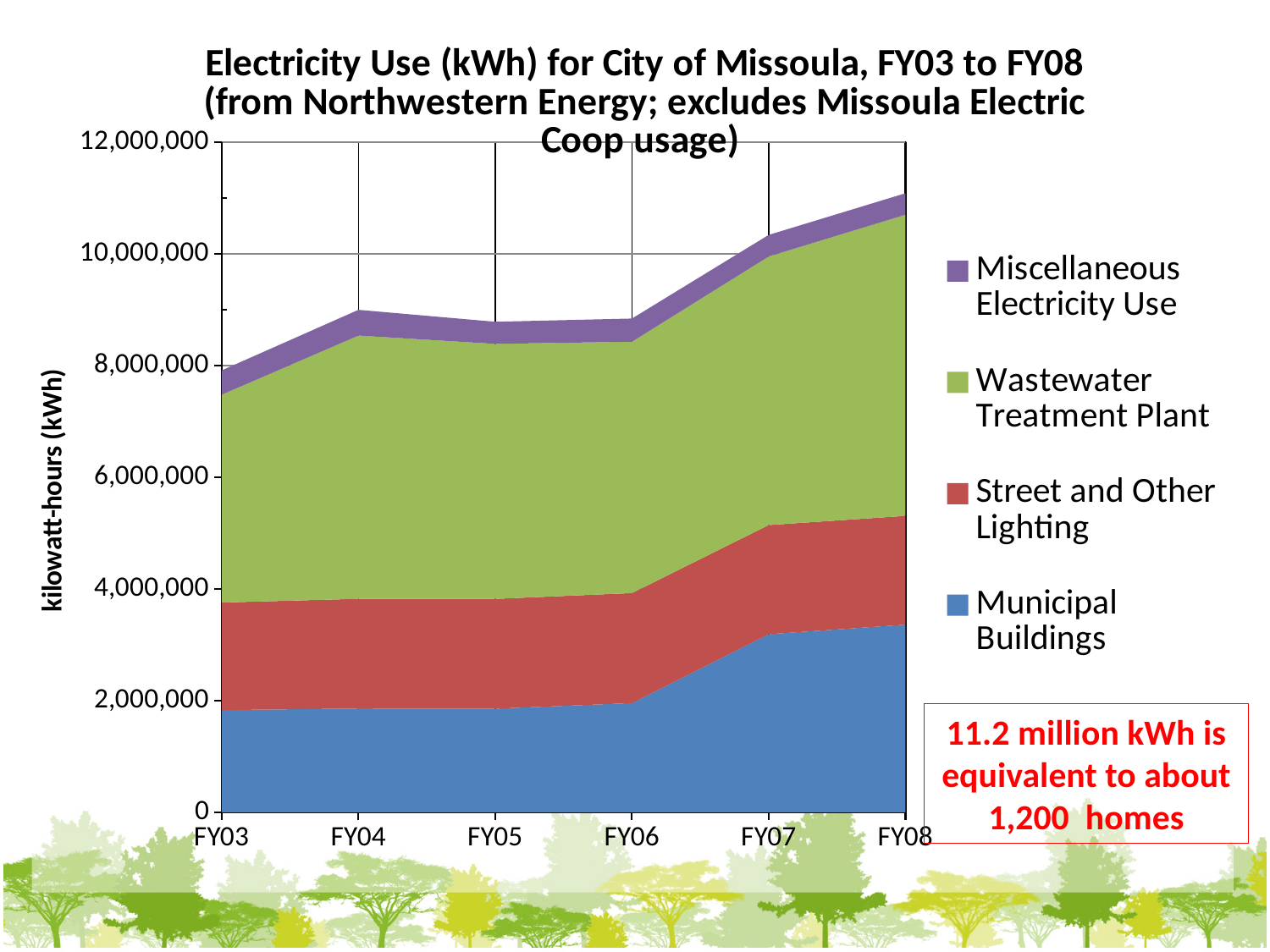
How many series does the legend list? 4 Which fiscal year has the highest total electricity use? FY08 Is the total electricity use in FY03 greater or less than 6,000,000 kWh? greater What is the label on the y axis? kilowatt-hours (kWh) What kind of chart is shown on the slide? stacked area chart Which is larger, the total electricity use in FY08 or in FY03? FY08 Is the total electricity use in FY05 greater or less than 10,000,000 kWh? less Is the total electricity use in FY08 greater or less than 10,000,000 kWh? greater Which fiscal year has the lowest total electricity use? FY03 Does total electricity use rise or fall from FY03 to FY08? rise How many fiscal years are plotted along the x axis? 6